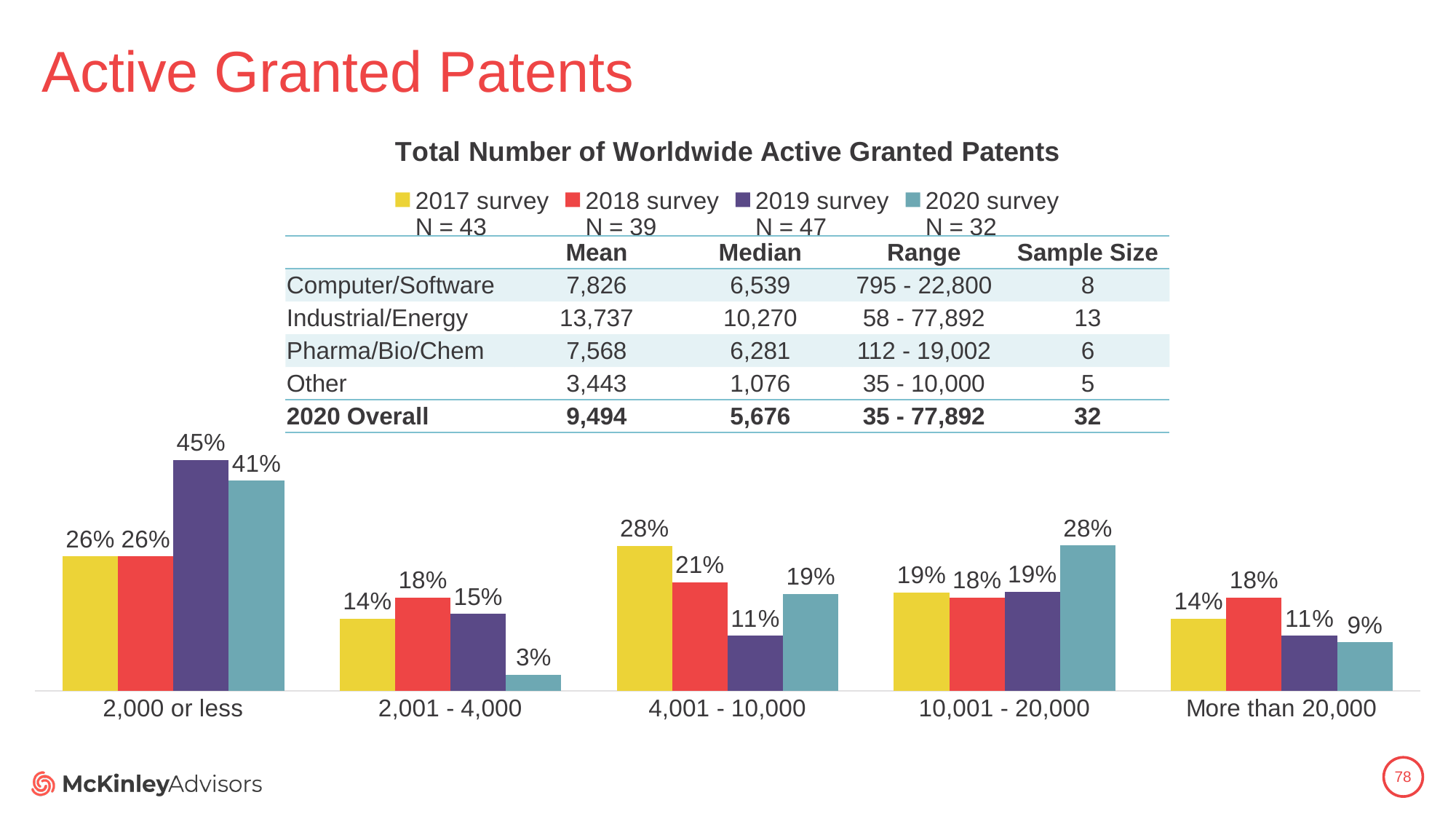
What percentage of 2020 survey respondents reported 2,000 or less active granted patents? 41% In the 10,001 - 20,000 category, which survey has the larger value: 2020 survey or 2018 survey? 2020 survey What is the 2017 survey value for the 4,001 - 10,000 category? 28% What is the 2019 survey value for the 2,001 - 4,000 category? 15% Which category has the lowest 2020 survey value? 2,001 - 4,000 What is the title of the chart? Total Number of Worldwide Active Granted Patents Which category has the highest 2020 survey value? 2,000 or less How many survey series does the chart legend list? 4 How many patent-count categories are shown on the x axis of the chart? 5 What is the difference between the 2019 survey and 2017 survey values for the 2,000 or less category? 19% What type of chart is shown on the slide? Bar chart What is the sample size (N) for the 2020 survey shown in the legend? N = 32